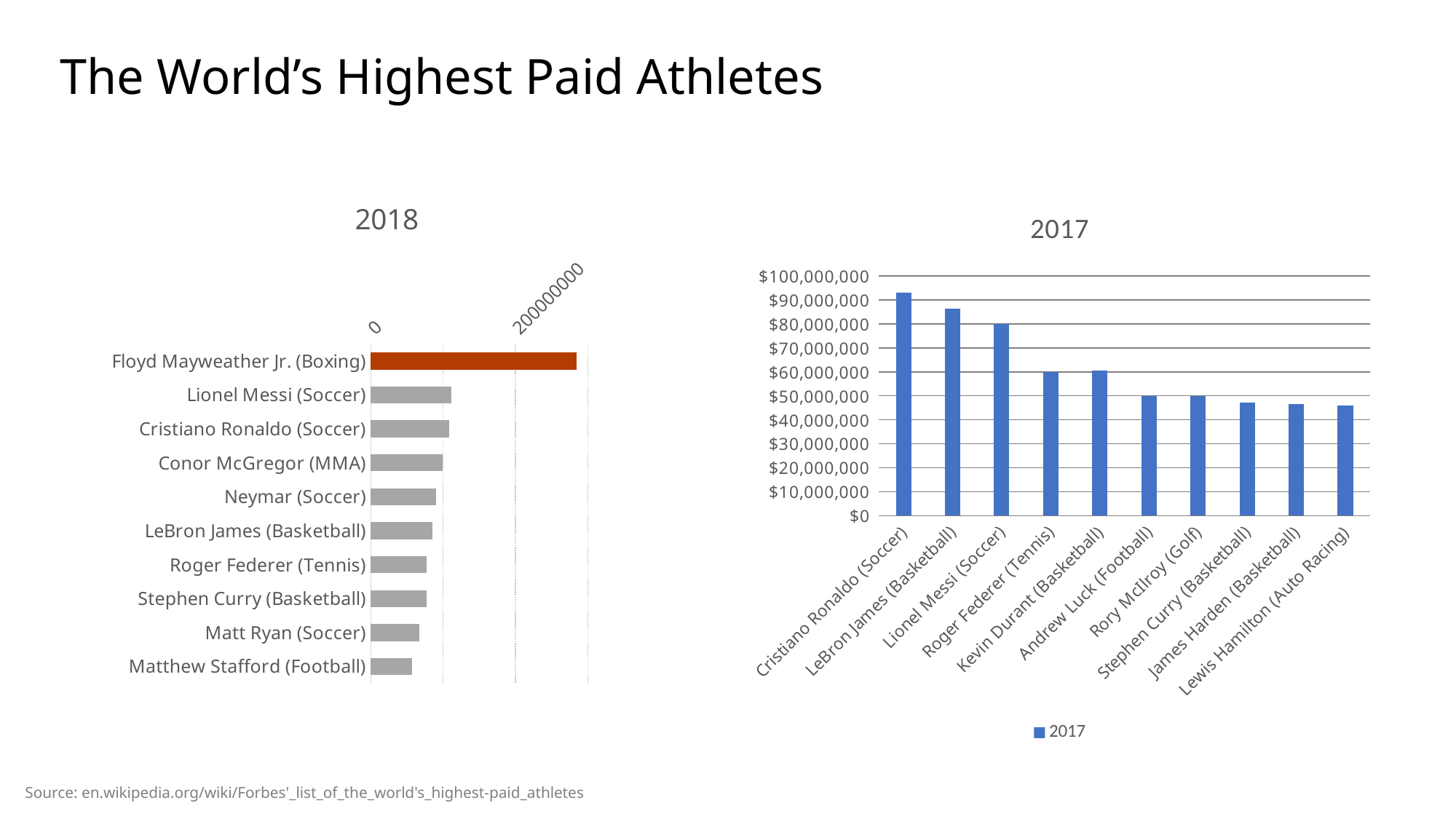
In the 2018 chart, is the value for Floyd Mayweather Jr. (Boxing) greater or less than 200000000? greater In the 2018 chart, which athlete has the highest earnings? Floyd Mayweather Jr. (Boxing) How many athletes are shown in the 2017 chart? 10 What kind of chart is the 2018 chart on the left? bar chart How many series does the legend of the 2017 chart list? 1 In the 2017 chart, which athlete has the highest earnings? Cristiano Ronaldo (Soccer) In the 2018 chart, is the value for Lionel Messi (Soccer) greater or less than 200000000? less In the 2018 chart, which athlete has the lowest earnings? Matthew Stafford (Football) In the 2018 chart, which bar is shown in a different colour from the others? Floyd Mayweather Jr. (Boxing) In the 2017 chart, is the value for Cristiano Ronaldo (Soccer) greater or less than $90,000,000? greater In the 2017 chart, which is larger, the value for LeBron James (Basketball) or Lionel Messi (Soccer)? LeBron James (Basketball) How many athletes are shown in the 2018 chart? 10